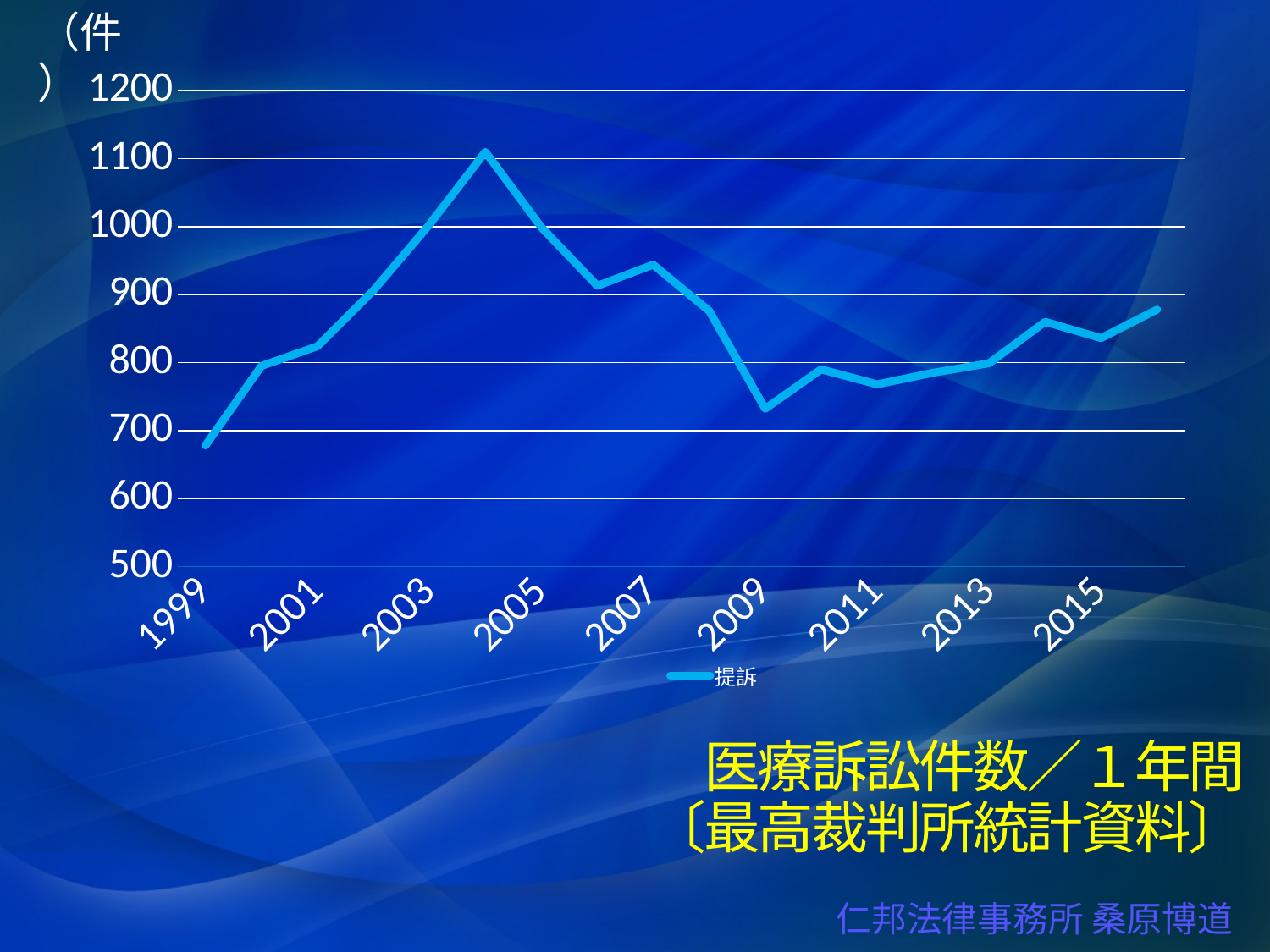
What is the name of the series shown in the legend? 提訴 Do the values rise or fall from 2004 to 2009? fall Is the value for 2004 greater or less than 1000? greater What kind of chart is shown on the slide? line chart Is the value for 2007 greater or less than 900? greater Is the value for 1999 greater or less than 700? less In which year does the line have its lowest value? 1999 How many series does the legend list? 1 Which year has the larger value, 2004 or 2009? 2004 In which year does the line reach its highest value? 2004 Do the values rise or fall from 1999 to 2004? rise